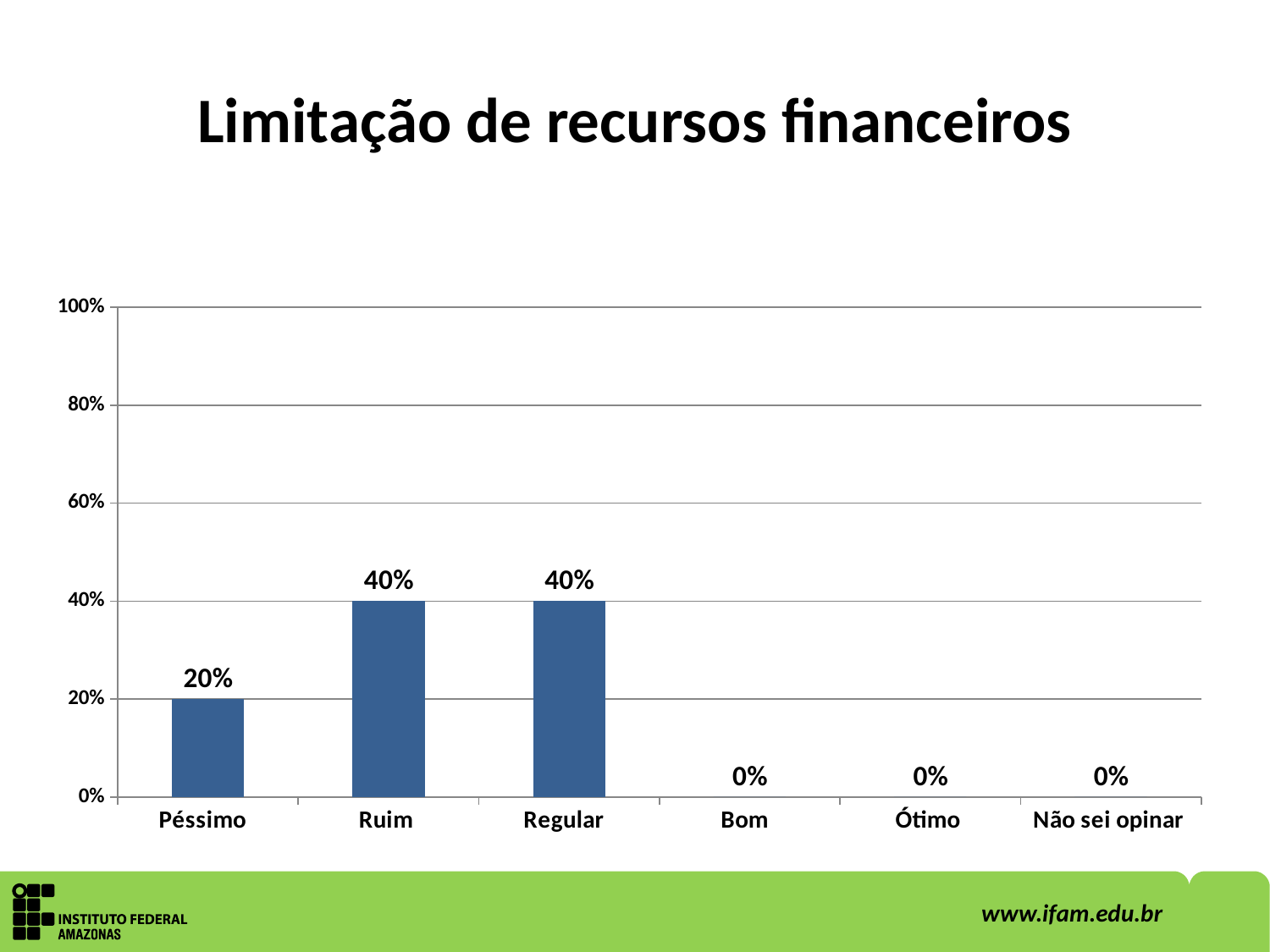
What kind of chart is shown on the slide? bar chart What is the value for Péssimo? 20% What is the value for Ruim? 40% How many categories are shown on the x axis? 6 Which is larger, the value for Péssimo or the value for Regular? Regular What is the highest value shown on the y axis? 100% What is the value for Não sei opinar? 0% What is the title of the slide? Limitação de recursos financeiros Is the value for Ruim greater or less than 60%? less What is the difference between the values for Ruim and Péssimo? 20% What is the value for Bom? 0% What is the value for Regular? 40%